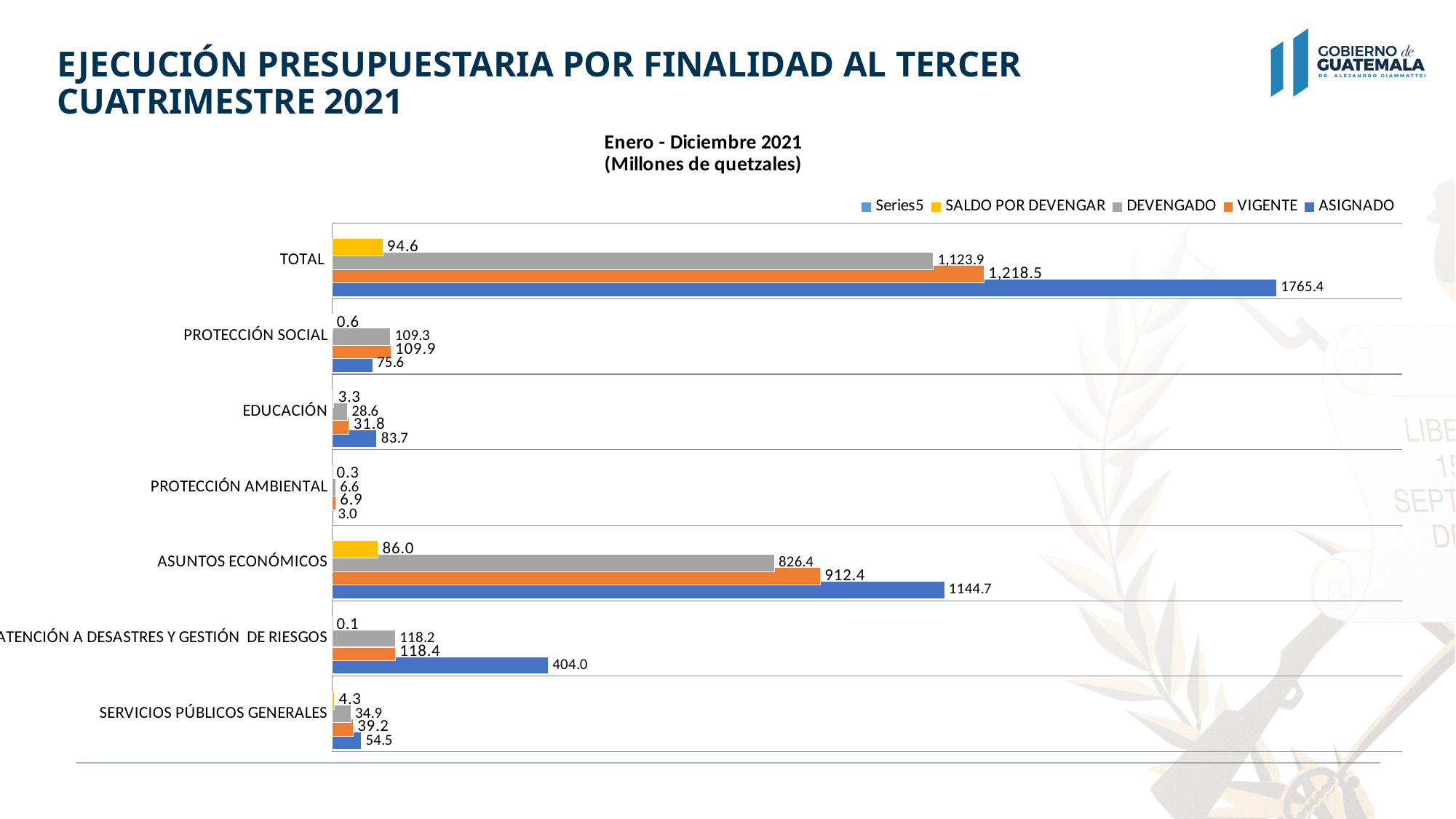
What is the ASIGNADO value for ASUNTOS ECONÓMICOS? 1144.7 What is the difference between the VIGENTE and DEVENGADO values for TOTAL? 94.6 Which is larger, the ASIGNADO value for EDUCACIÓN or the ASIGNADO value for PROTECCIÓN SOCIAL? EDUCACIÓN What kind of chart is shown on the slide? Bar chart Which category has the lowest ASIGNADO value? PROTECCIÓN AMBIENTAL What is the SALDO POR DEVENGAR value for SERVICIOS PÚBLICOS GENERALES? 4.3 What is the VIGENTE value for ATENCIÓN A DESASTRES Y GESTIÓN DE RIESGOS? 118.4 Excluding TOTAL, which category has the highest ASIGNADO value? ASUNTOS ECONÓMICOS What is the difference between the ASIGNADO and VIGENTE values for ATENCIÓN A DESASTRES Y GESTIÓN DE RIESGOS? 285.6 How many series does the legend list? 5 How many categories are shown on the chart? 7 What is the DEVENGADO value for TOTAL? 1,123.9